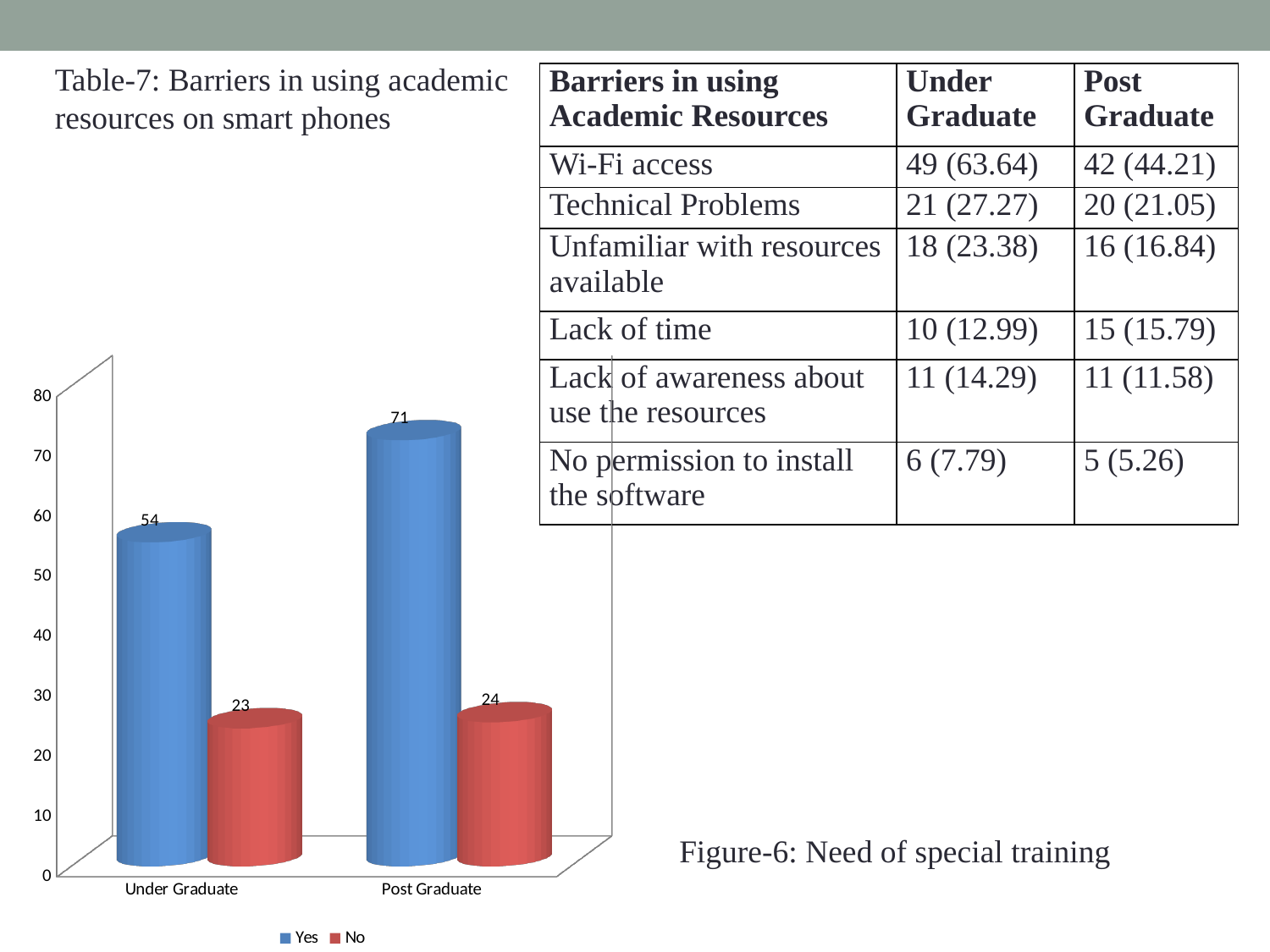
What is the value for No among Post Graduate students in the chart? 24 What is the value for No among Under Graduate students in the chart? 23 Which is larger in the chart: Yes for Under Graduate or No for Post Graduate? Yes for Under Graduate What is the caption of the chart on the slide? Figure-6: Need of special training What is the value for Yes among Under Graduate students in the chart? 54 Which group has the highest Yes value in the chart? Post Graduate What is the difference between the Yes values for Post Graduate and Under Graduate in the chart? 17 What kind of chart is shown on the slide? Bar chart How many series does the chart legend list? 2 Which group has the lowest No value in the chart? Under Graduate What is the value for Yes among Post Graduate students in the chart? 71 How many categories are shown on the x axis of the chart? 2